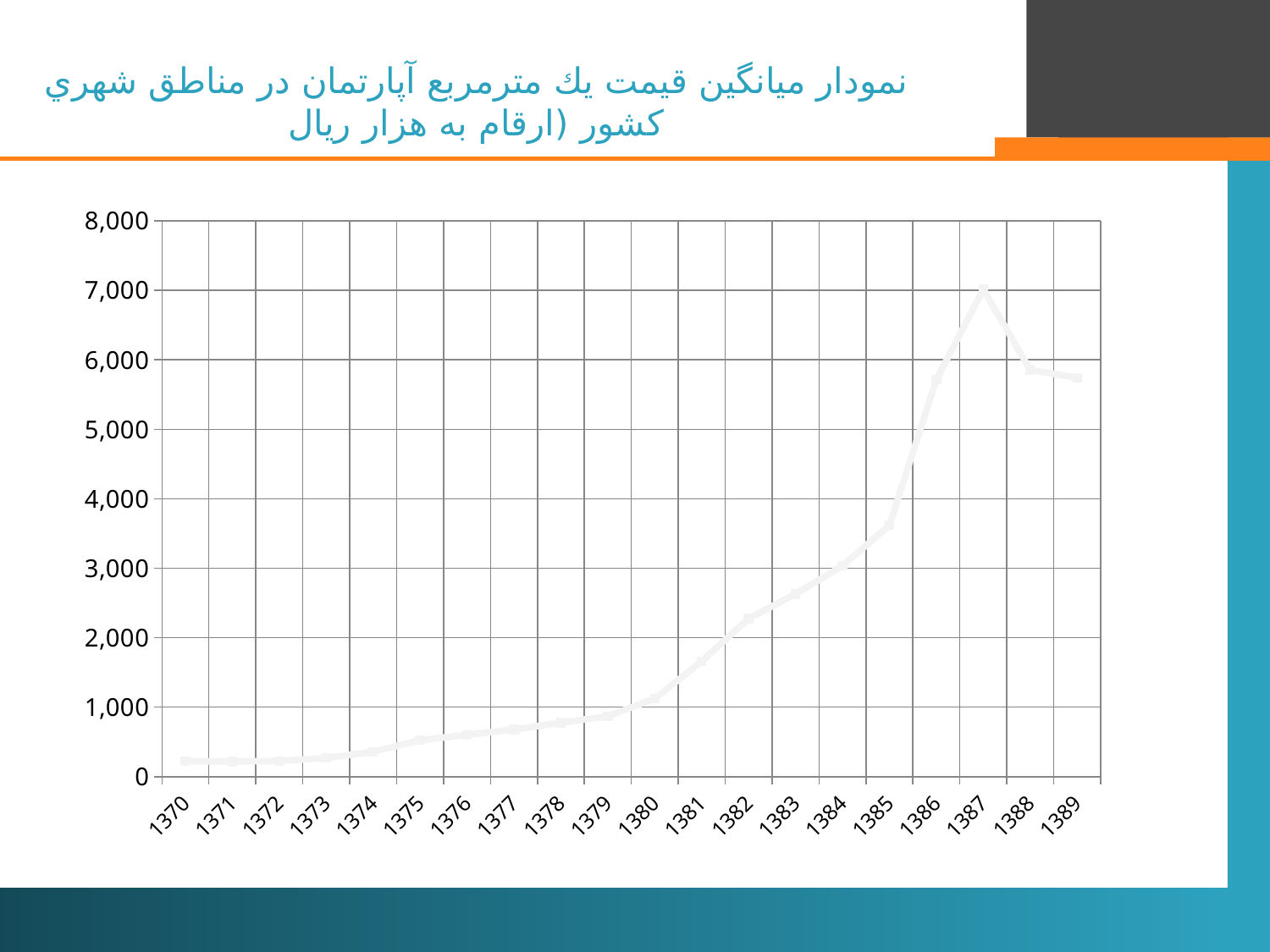
Is the value for 1385 greater or less than 3,000? greater What kind of chart is shown on the slide? line chart Do the values rise or fall from 1387 to 1389? fall Is the value for 1387 greater or less than 6,000? greater Is the value for 1375 greater or less than 1,000? less Which is larger, the value for 1387 or the value for 1389? 1387 How many years are plotted along the x axis? 20 Which year has the highest value? 1387 What is the highest tick value shown on the y axis? 8,000